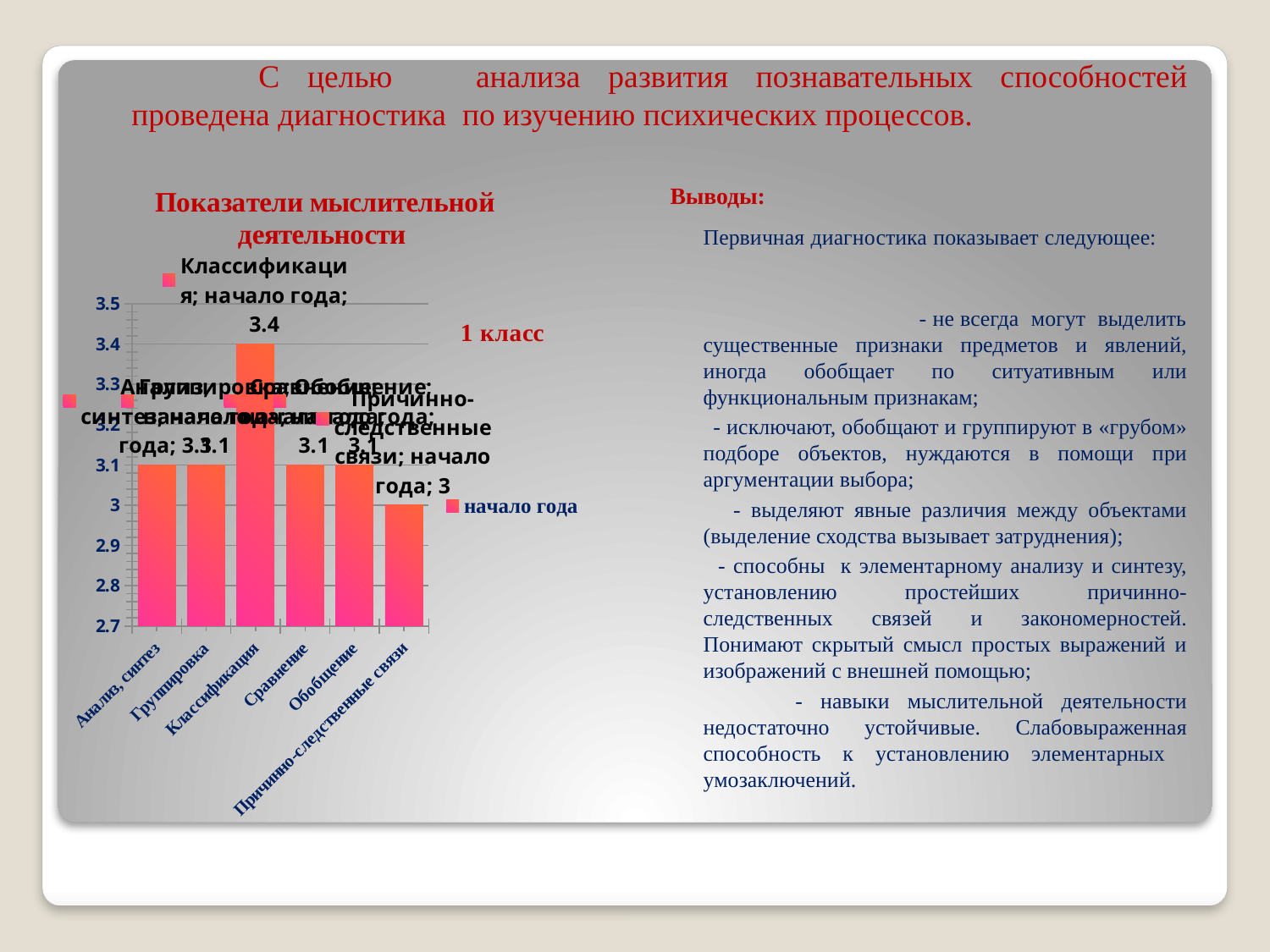
Which category has the lowest value? Причинно-следственные связи How many series does the chart legend list? 1 What is the value for Причинно-следственные связи? 3 Which category has the highest value? Классификация What is the value for Классификация? 3.4 What series name is shown in the chart legend? начало года What kind of chart is shown on the slide? bar chart What is the difference between the values for Классификация and Причинно-следственные связи? 0.4 What is the title of the chart? Показатели мыслительной деятельности How many categories are plotted in the chart? 6 What is the value for Группировка? 3.1 Which is larger, the value for Классификация or the value for Сравнение? Классификация